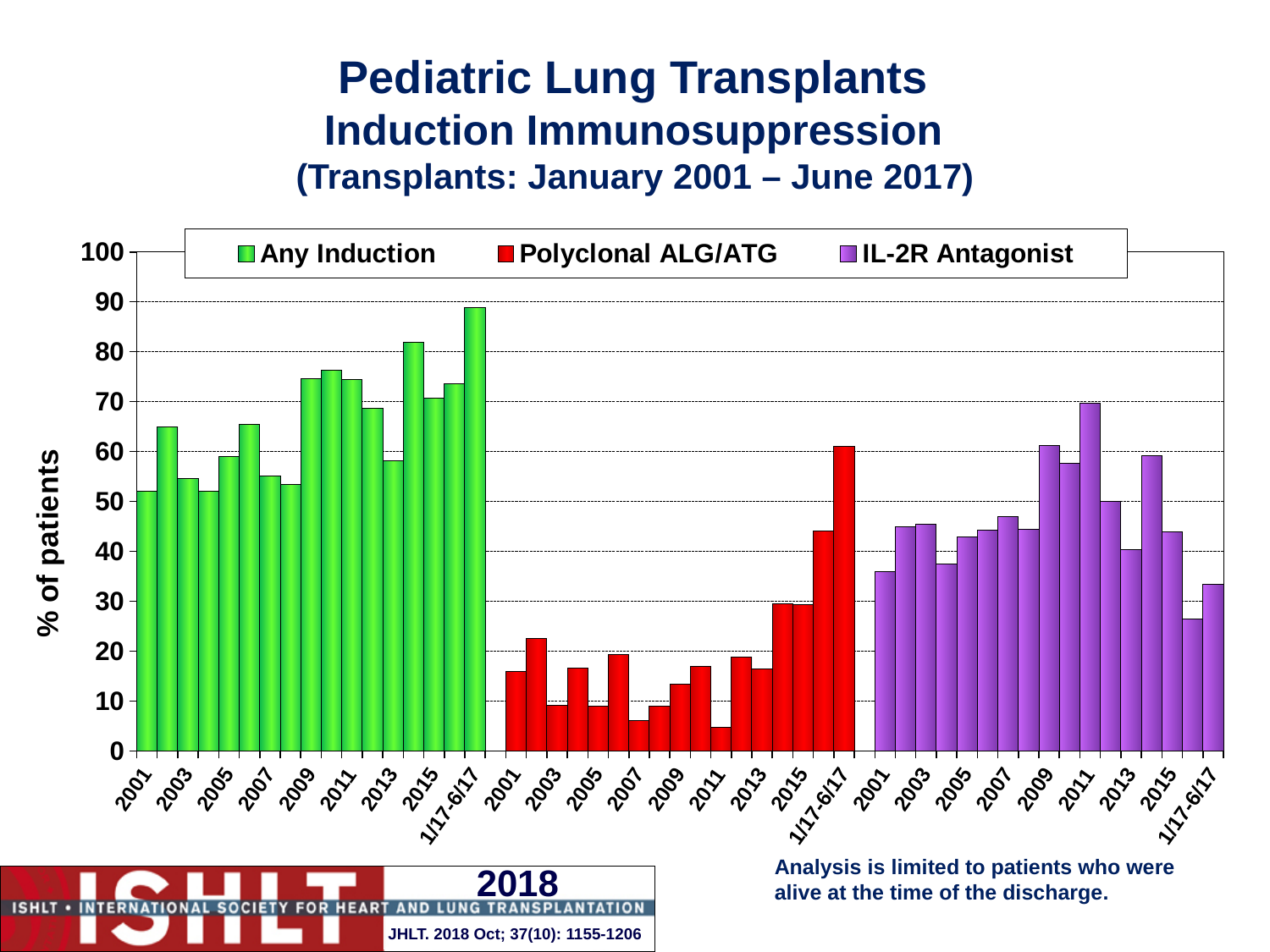
For the Any Induction series, which period has the highest value? 1/17-6/17 For the Polyclonal ALG/ATG series, do the values rise or fall from 2013 to 1/17-6/17? rise Is the Any Induction value for 1/17-6/17 greater or less than 80? greater How many series does the legend list? 3 What is the label on the vertical axis? % of patients What are the three series named in the legend? Any Induction, Polyclonal ALG/ATG, IL-2R Antagonist Is the Polyclonal ALG/ATG value for 2001 greater or less than 20? less For the IL-2R Antagonist series, which year has the highest value? 2011 For the Any Induction series, which is larger: the value for 2009 or the value for 2003? 2009 What kind of chart is shown on the slide? bar chart Is the IL-2R Antagonist value for 2001 greater or less than 40? less For the Polyclonal ALG/ATG series, which period has the highest value? 1/17-6/17